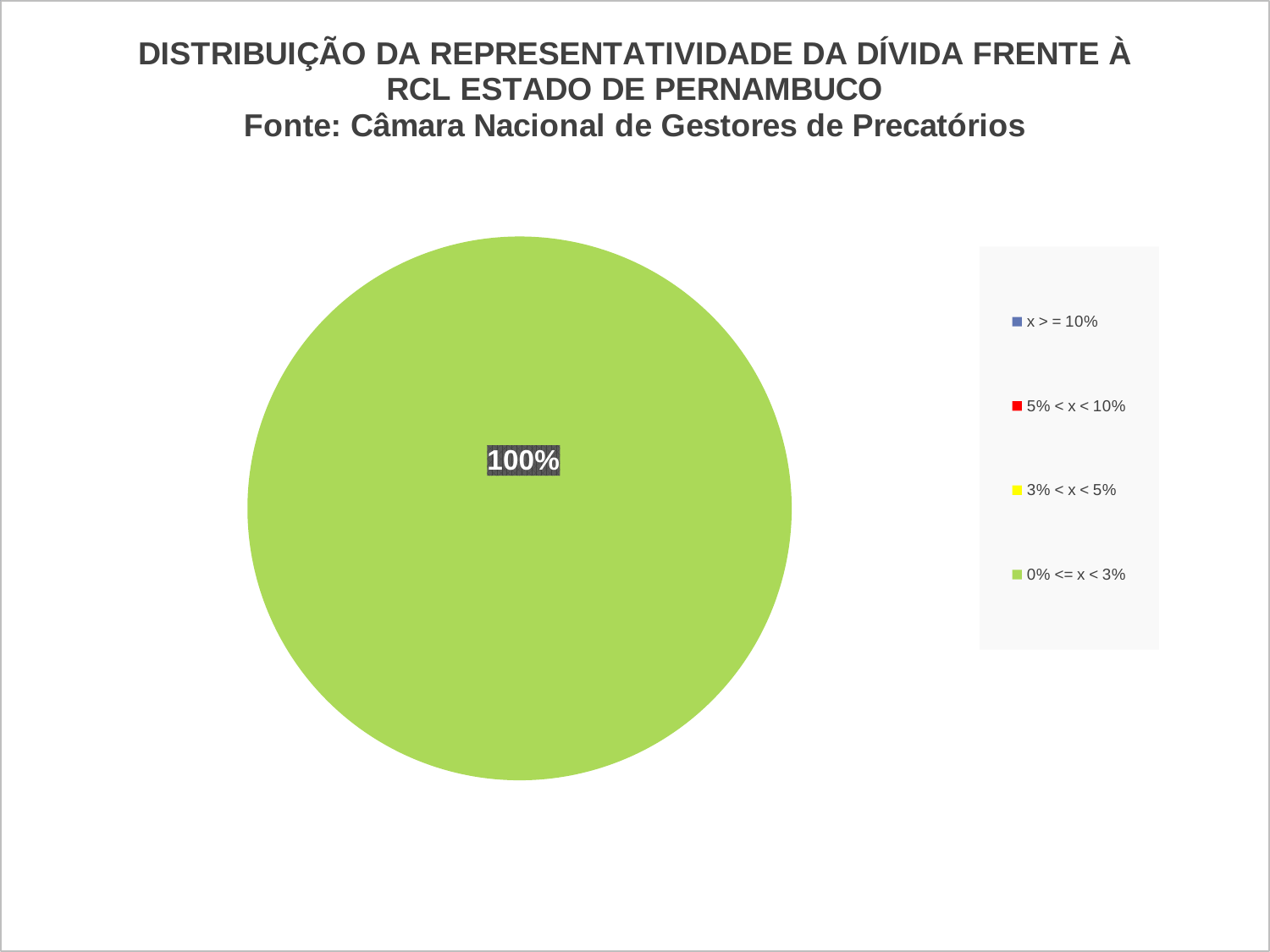
What share of the pie does the "0% <= x < 3%" category hold? 100% Is the share for "0% <= x < 3%" greater or less than 50%? greater According to the chart title, which state's data is shown? Pernambuco How many slices are visible in the pie chart? 1 How many entries does the legend list? 4 What kind of chart is shown on the slide? pie chart What colour is the slice representing "0% <= x < 3%"? green What value is printed on the pie slice? 100% Which category accounts for the largest share of the pie? 0% <= x < 3%